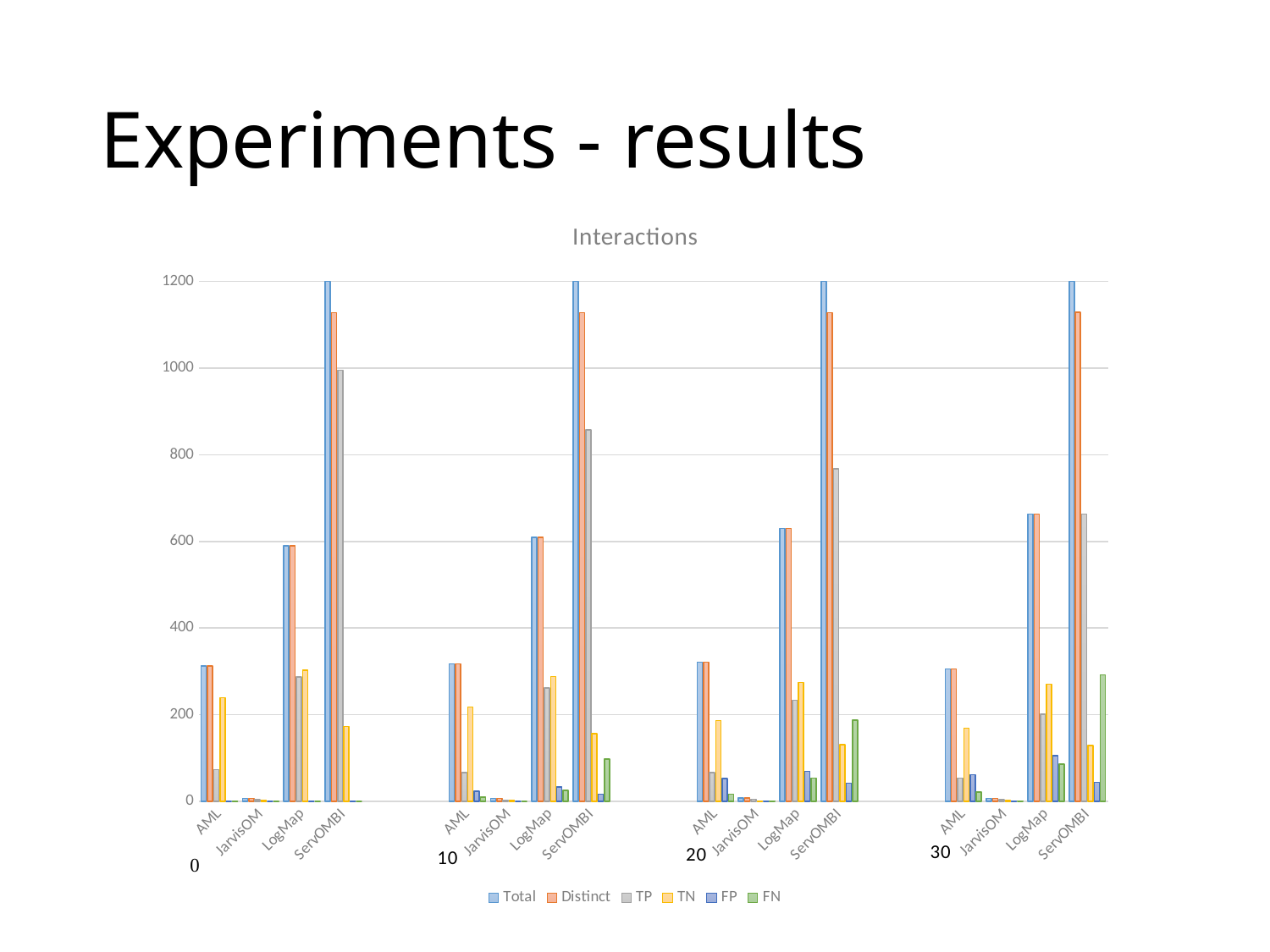
In the group labelled 0, which tool has the highest Total value? ServOMBI How many tool categories are shown within each group (0, 10, 20, 30)? 4 In the group labelled 0, is the TP value for ServOMBI greater or less than 800? greater How many series does the legend list? 6 In the group labelled 20, is the TP value for ServOMBI greater or less than 800? less Which series is shown in green in the legend? FN What kind of chart is shown on the slide? bar chart Does the TP value for ServOMBI rise or fall across the groups 0, 10, 20 and 30? fall In the group labelled 0, which is larger: the Total value for LogMap or the Total value for AML? LogMap What is the title of the chart? Interactions In the group labelled 0, which tool has the lowest Total value? JarvisOM